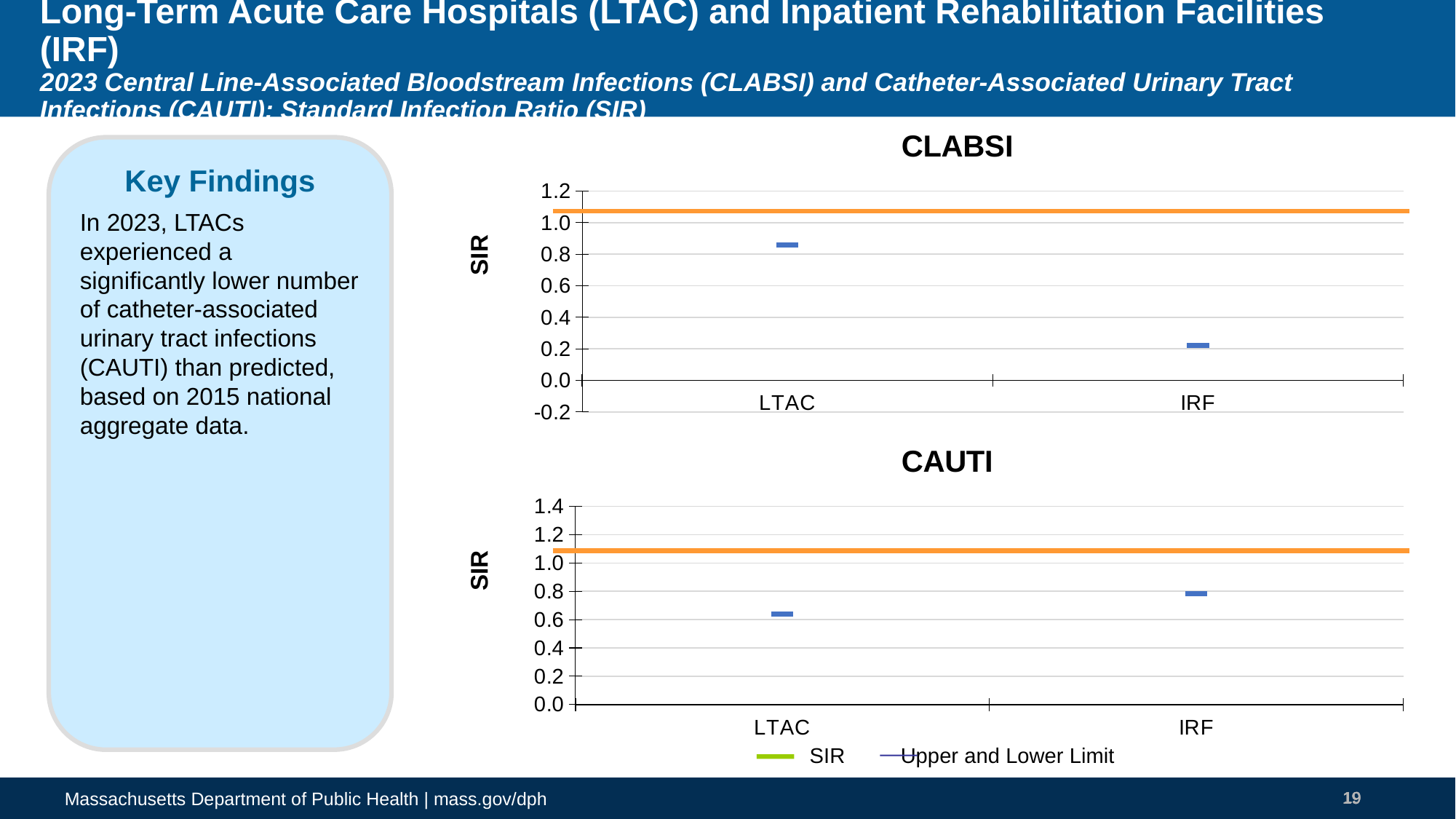
On the CLABSI chart, which category has the lowest SIR? IRF On the CAUTI chart, is the value for LTAC greater or less than 0.8? less On the CAUTI chart, is the value for IRF greater or less than 0.6? greater What are the two entries in the legend below the CAUTI chart? SIR; Upper and Lower Limit On the CAUTI chart, which category has the higher SIR, LTAC or IRF? IRF How many categories are shown on the x axis of the CLABSI chart? 2 On the CAUTI chart, is the orange Upper and Lower Limit line above or below 1.0? above On the CLABSI chart, which category has the higher SIR, LTAC or IRF? LTAC What is the label on the y axis of the CAUTI chart? SIR How many series does the legend below the CAUTI chart list? 2